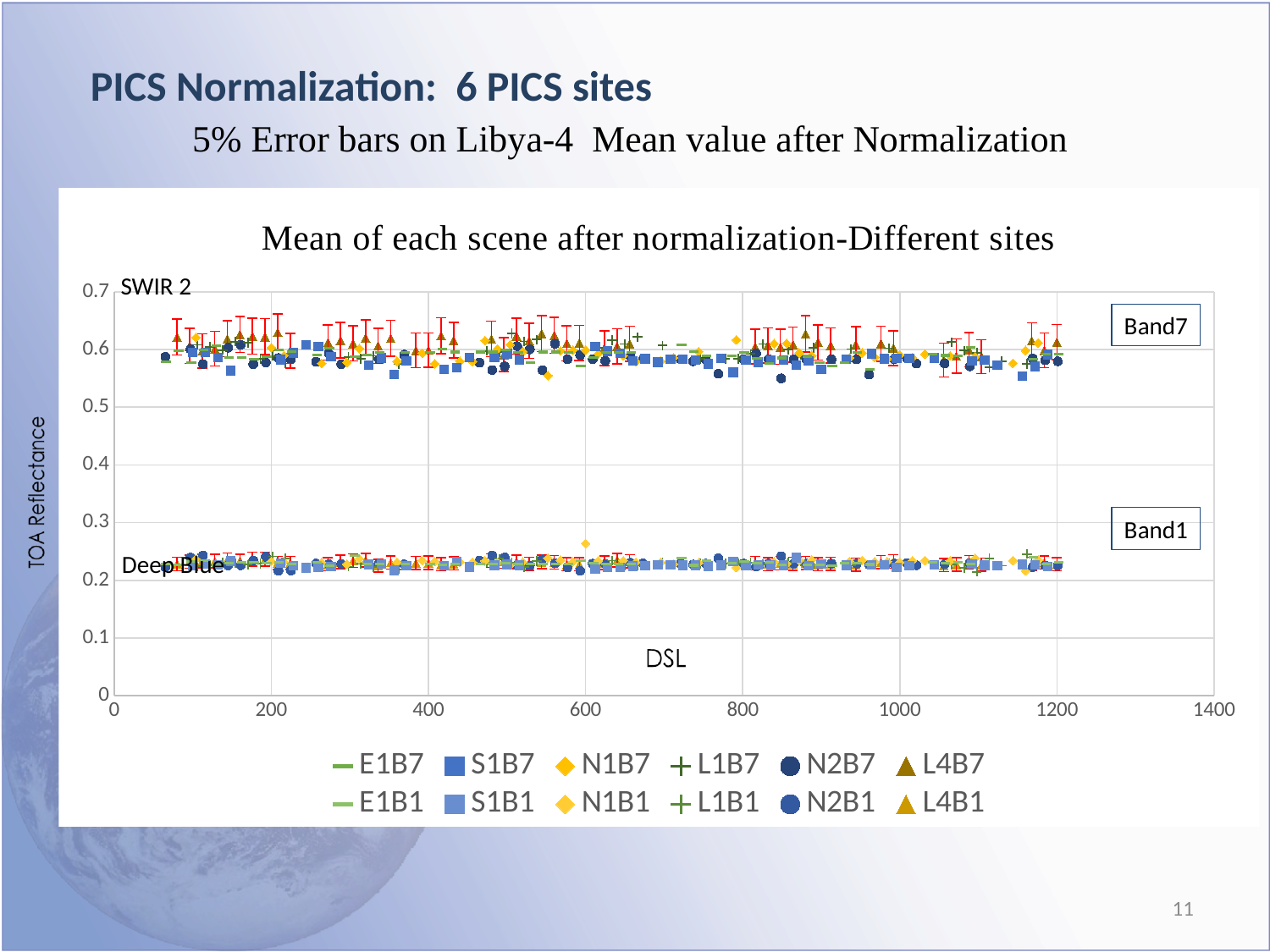
How many series does the chart legend list? 12 Are the Band7 (SWIR 2) values greater or less than 0.5? greater Do the Band1 values show a clear rising or falling trend along the DSL axis, or do they stay roughly flat? Roughly flat What kind of chart is shown on the slide? Scatter chart Are the Band1 (Deep Blue) values greater or less than 0.3? less Do the Band7 values show a clear rising or falling trend along the DSL axis, or do they stay roughly flat? Roughly flat Are the Band1 (Deep Blue) values greater or less than 0.1? greater What is the highest value shown on the x axis of the chart? 1400 What is the label on the y axis of the chart? TOA Reflectance Which group of points has higher TOA Reflectance values, Band7 or Band1? Band7 What is the title of the chart? Mean of each scene after normalization-Different sites